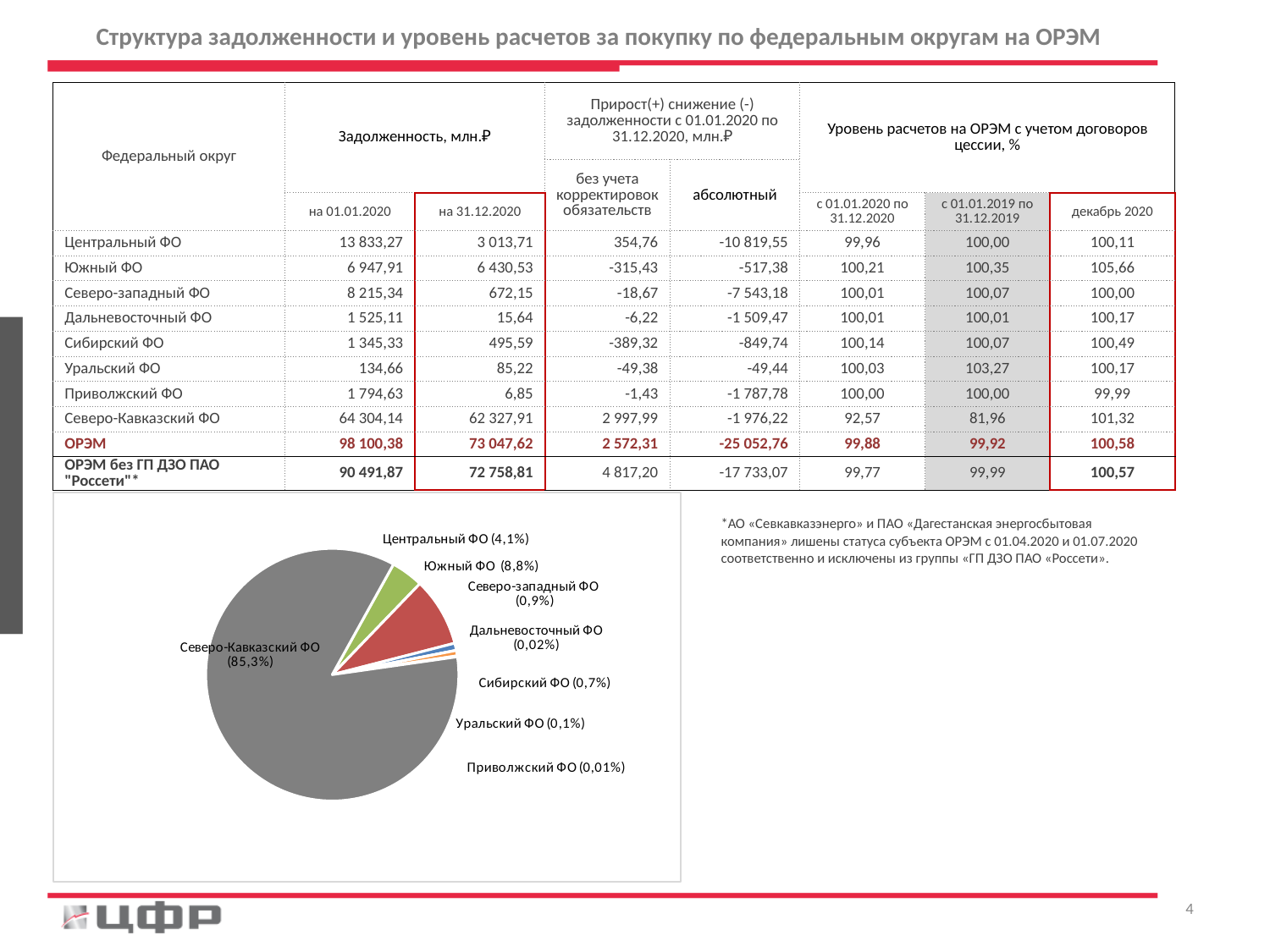
How many slices does the pie chart have? 8 What share of the pie chart does Сибирский ФО hold? 0,7% What share of the pie chart does Дальневосточный ФО hold? 0,02% Which slice is larger in the pie chart, Южный ФО or Центральный ФО? Южный ФО What share of the pie chart does Центральный ФО hold? 4,1% What kind of chart is shown on the slide? pie chart What is the difference in share between Южный ФО and Центральный ФО in the pie chart? 4,7% Which slice of the pie chart is the smallest? Приволжский ФО Which slice of the pie chart is the largest? Северо-Кавказский ФО